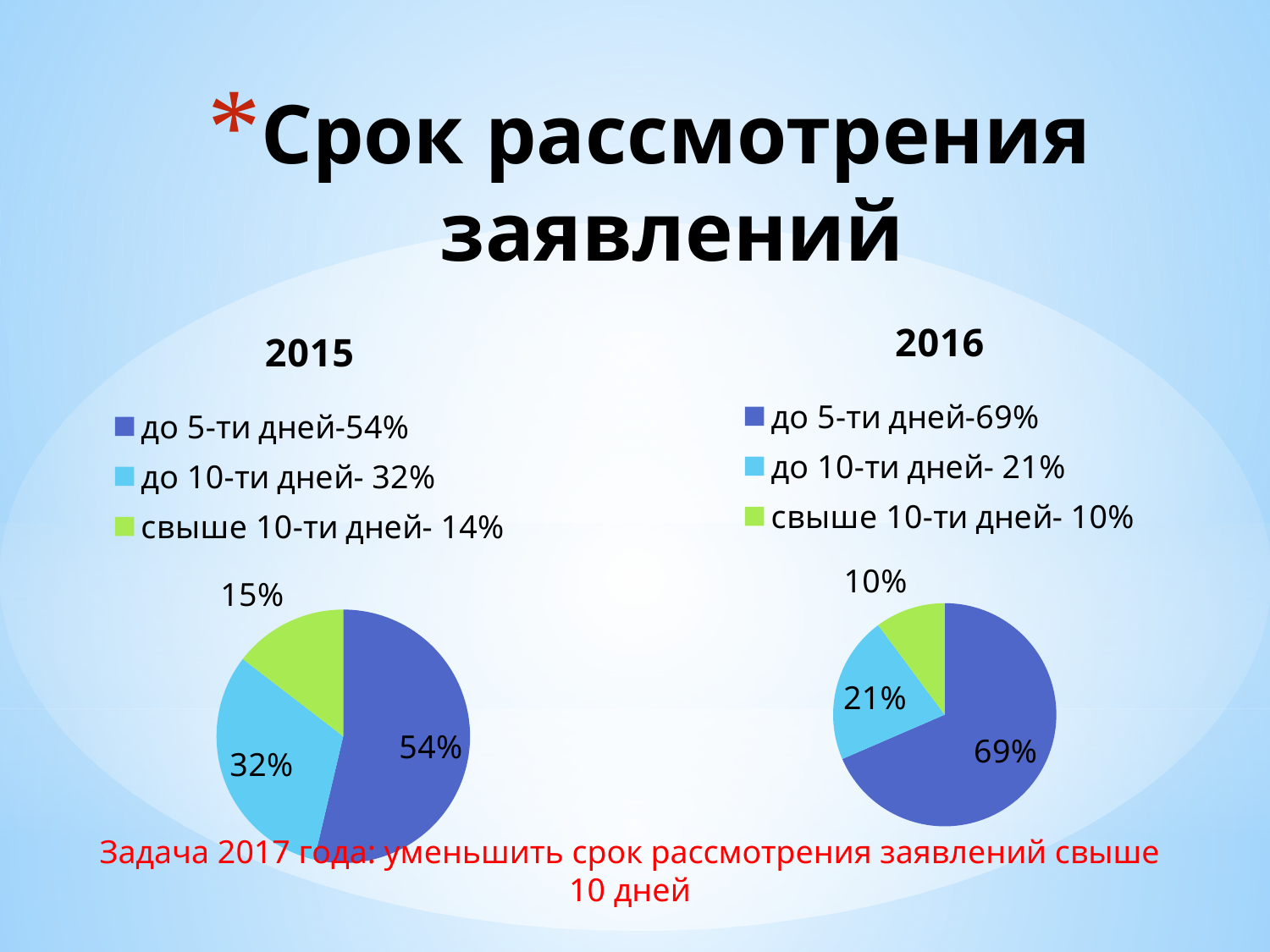
What is the difference between the "до 5-ти дней" share in the 2016 chart and in the 2015 chart? 15% In the 2016 chart, what share is labelled for the "до 10-ти дней" slice? 21% How many slices does the 2016 pie chart have? 3 In the 2015 chart, what share is labelled for the "до 10-ти дней" slice? 32% In the 2016 chart, which category has the largest slice? до 5-ти дней In the 2016 chart, which category has the smallest slice? свыше 10-ти дней In the 2015 chart, which category has the largest slice? до 5-ти дней Which is larger: the "до 10-ти дней" slice in the 2015 chart or in the 2016 chart? 2015 What kind of chart is the 2015 chart? pie chart In the 2015 chart, what share is labelled for the "до 5-ти дней" slice? 54% In the 2016 chart, what share is labelled for the "свыше 10-ти дней" slice? 10% In the 2016 chart, what share is labelled for the "до 5-ти дней" slice? 69%